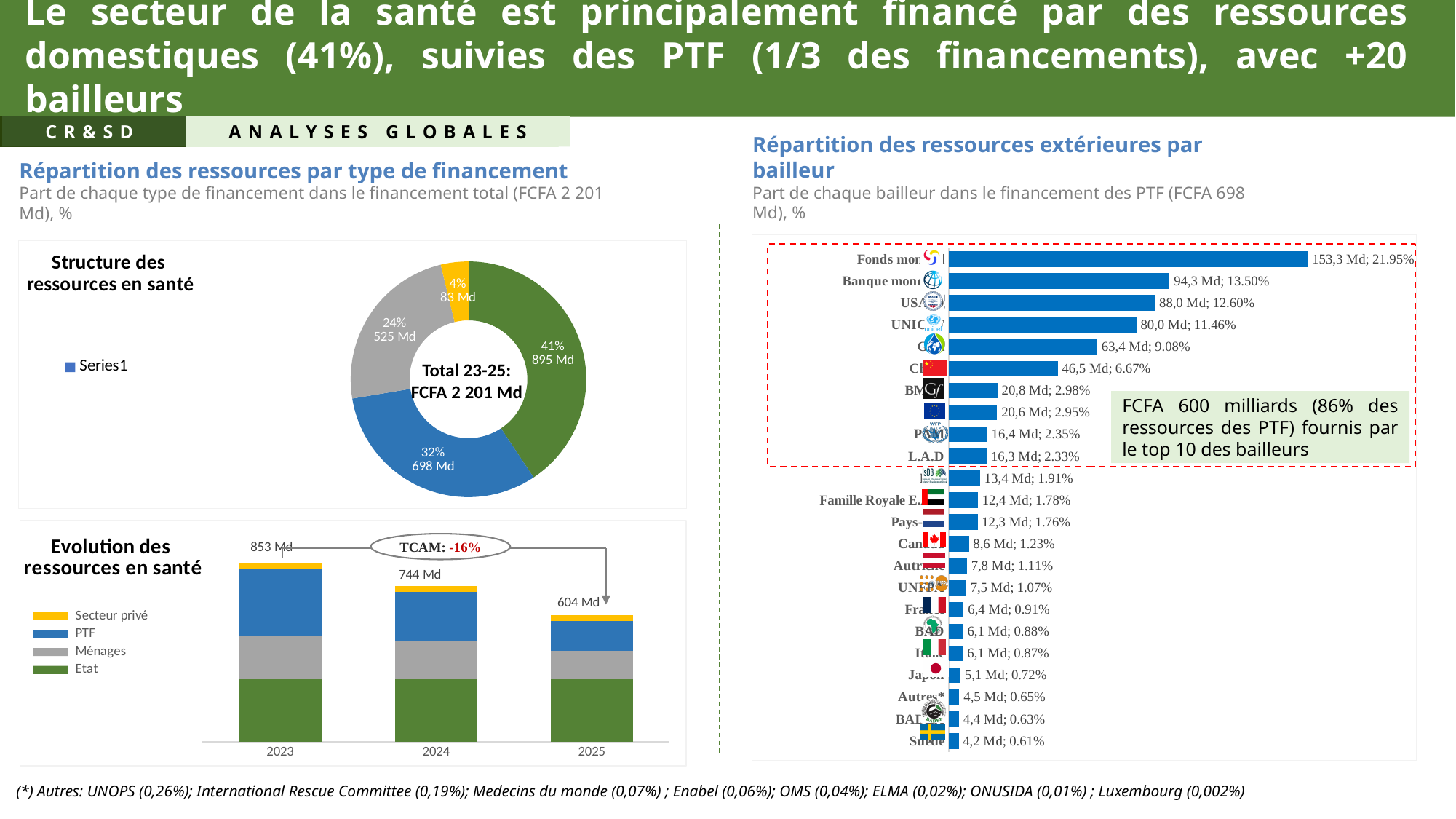
In the 'Evolution des ressources en santé' chart, do the yearly totals rise or fall from 2023 to 2025? fall In the 'Répartition des ressources extérieures par bailleur' chart, which bailleur has the highest value? Fonds mondial In the 'Evolution des ressources en santé' chart, what is the difference between the 2024 total and the 2025 total? 140 Md In the 'Structure des ressources en santé' donut chart, what total is shown in the centre? Total 23-25: FCFA 2 201 Md In the 'Répartition des ressources extérieures par bailleur' chart, which is larger: the value for Canada or the value for Autriche? Canada In the 'Structure des ressources en santé' donut chart, what is the difference in Md between the 32% slice and the 24% slice? 173 Md In the 'Structure des ressources en santé' donut chart, what value in Md corresponds to the 41% slice? 895 Md In the 'Evolution des ressources en santé' chart, what is the total for 2023? 853 Md In the 'Structure des ressources en santé' donut chart, what share does the smallest slice represent? 4% In the 'Evolution des ressources en santé' chart, what TCAM value is shown? -16% In the 'Répartition des ressources extérieures par bailleur' chart, what value and share are shown for USA? 88,0 Md; 12.60% In the 'Evolution des ressources en santé' chart, how many series does the legend list? 4